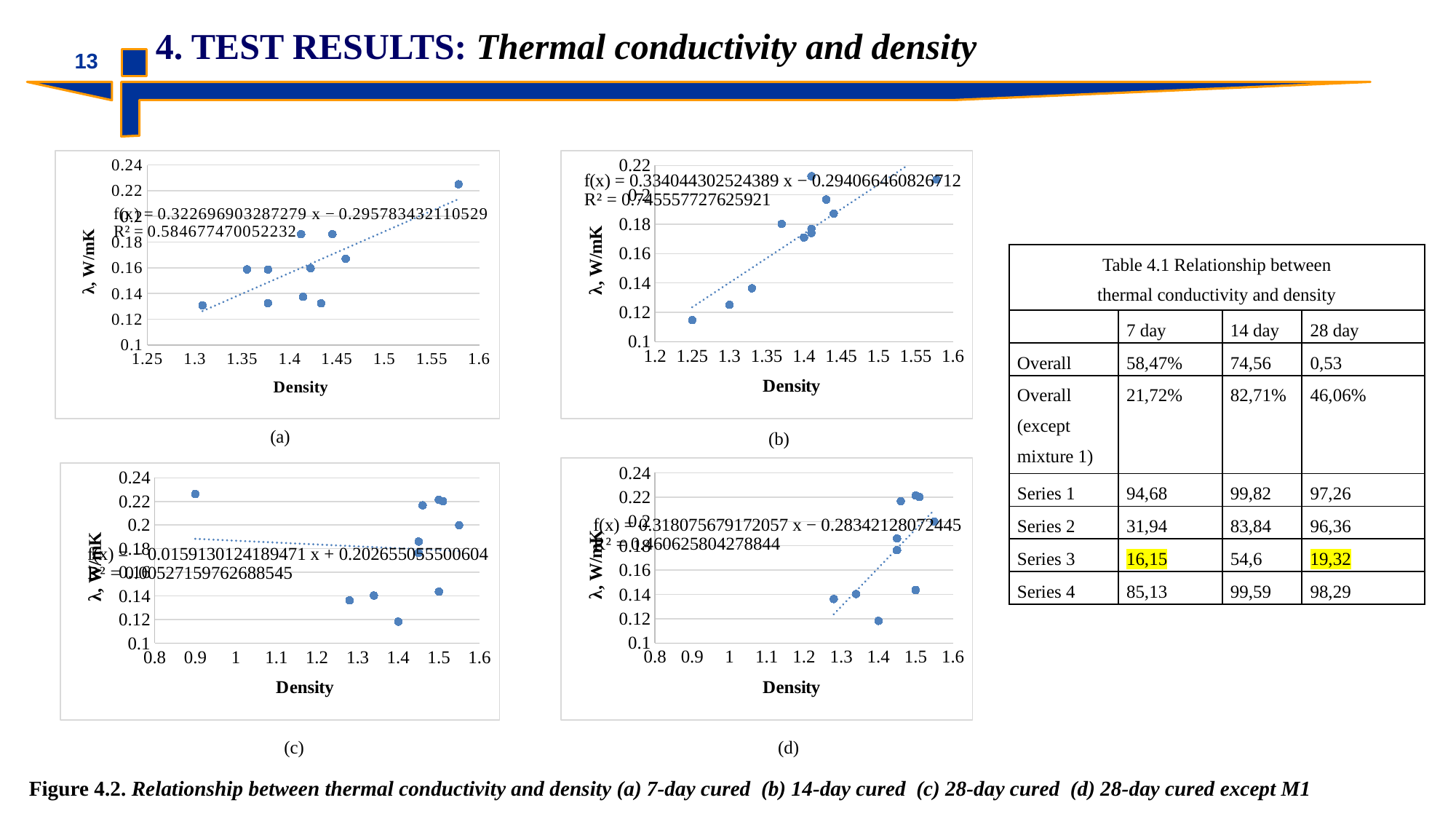
In chart (c), is the λ value of the point at density 0.9 greater or less than 0.22? greater In chart (a), is the λ value of the point at the highest density (about 1.58) greater or less than 0.22? greater What is the title of the x axis in chart (b)? Density In chart (b), do the λ values generally rise or fall as density increases along the x axis? Rise In chart (c), does the dotted trendline rise or fall as density increases? Fall In chart (b), is the λ value of the point at the lowest density (about 1.25) greater or less than 0.12? less In chart (d), do the λ values generally rise or fall as density increases along the x axis? Rise What R² value is printed on chart (a)? 0.584677470052232 What kind of chart is chart (a) on the slide? Scatter chart